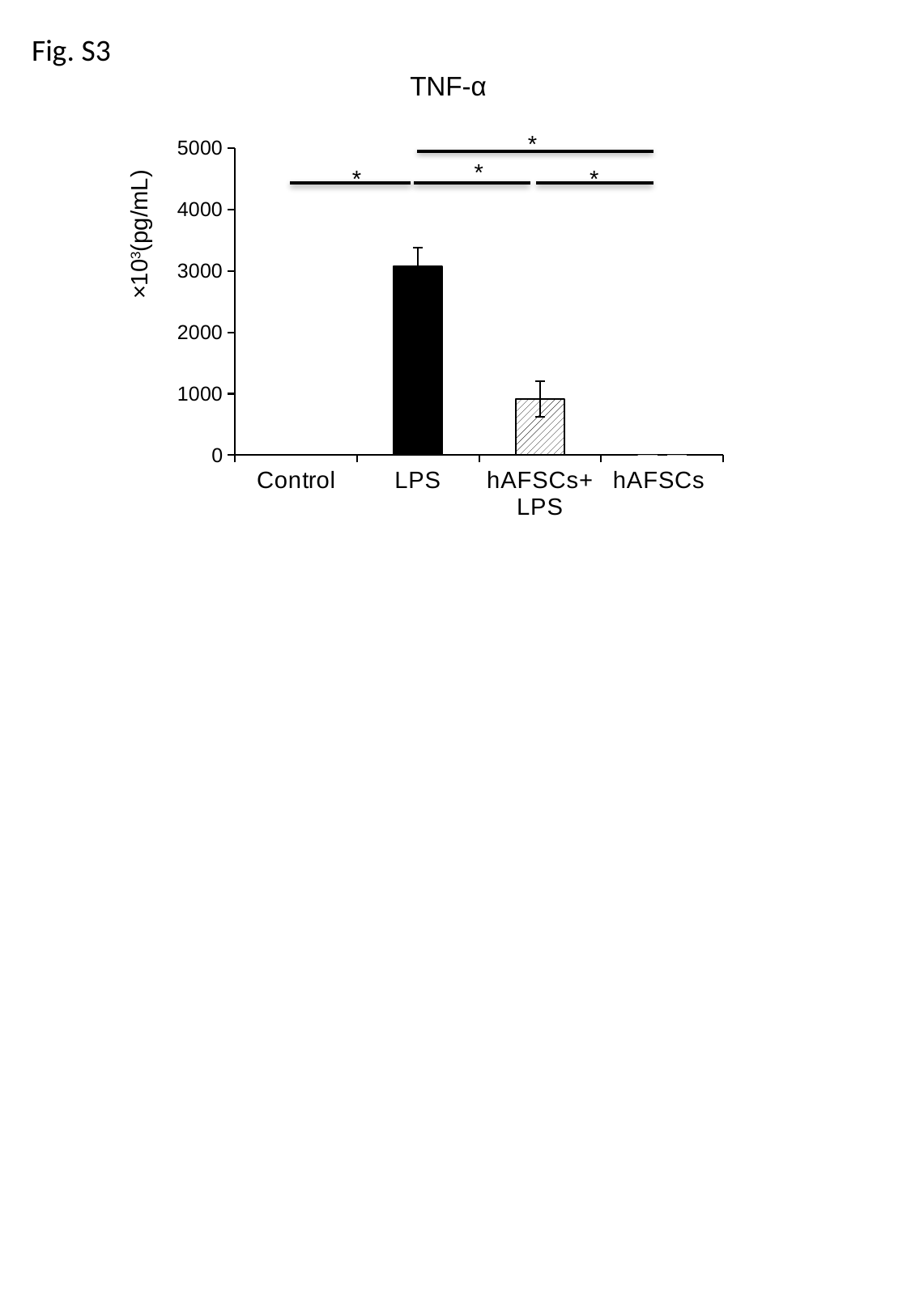
What is the maximum value shown on the y axis? 5000 How many categories are shown on the x axis? 4 What is the title of the chart? TNF-α Which is larger, the value for LPS or the value for hAFSCs+LPS? LPS What kind of chart is shown on the slide? bar chart Which category has the highest value? LPS Is the value for hAFSCs+LPS greater or less than 500? greater Is the value for LPS greater or less than 4000? less What is the label of the y axis? ×10³(pg/mL)